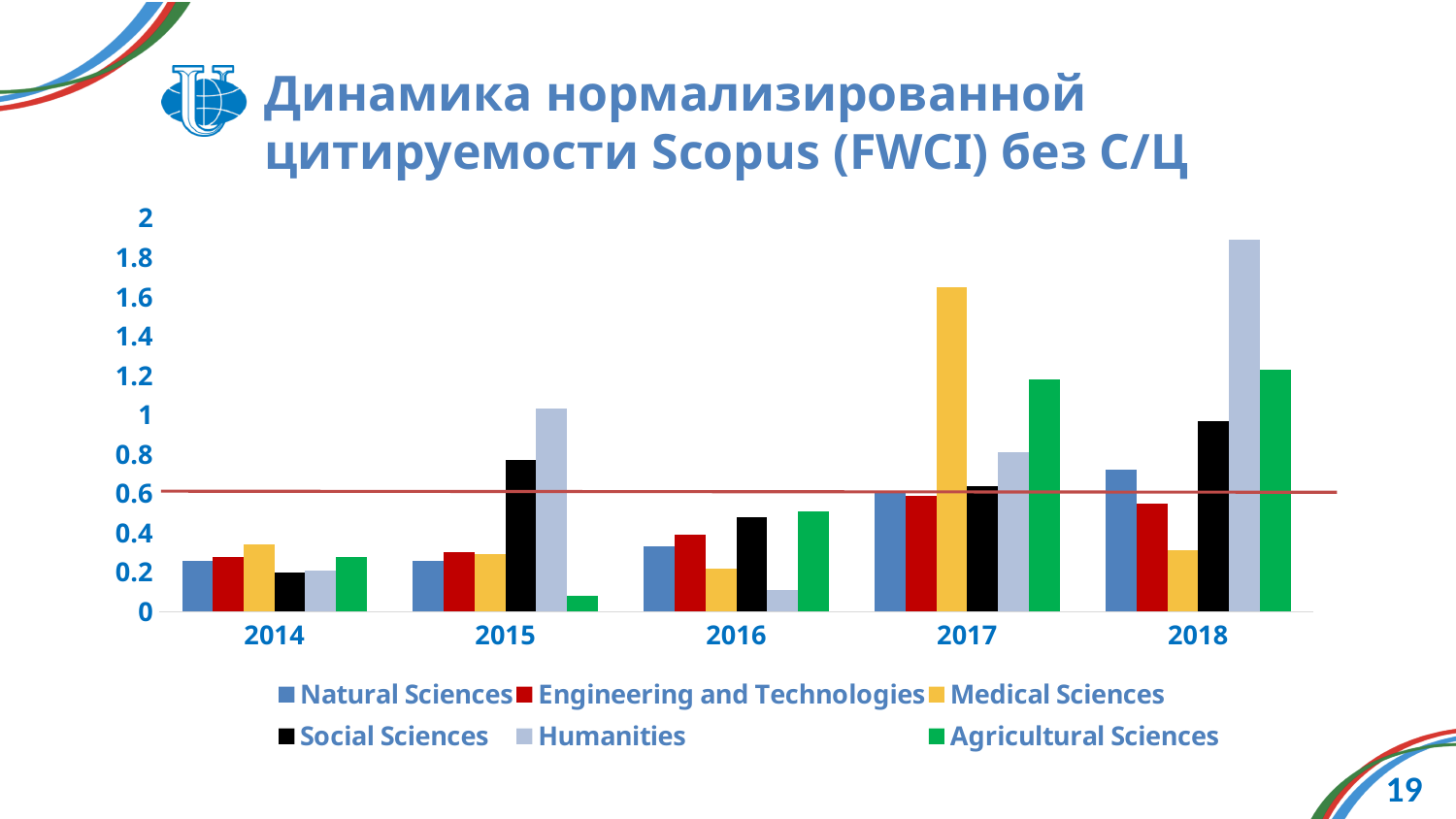
Is the value for Medical Sciences in 2017 greater or less than 1.4? greater Is the value for Humanities in 2018 greater or less than 1.6? greater How many years are shown on the x axis? 5 Do the Humanities values rise or fall from 2016 to 2018? rise Which series has the highest value in 2017? Medical Sciences Which series has the lowest value in 2015? Agricultural Sciences What kind of chart is shown on the slide? bar chart What colour represents Agricultural Sciences in the legend? green Which is larger in 2015: Humanities or Social Sciences? Humanities In which year is the Humanities value the highest? 2018 How many series does the legend list? 6 Is the value for Agricultural Sciences in 2015 greater or less than 0.2? less